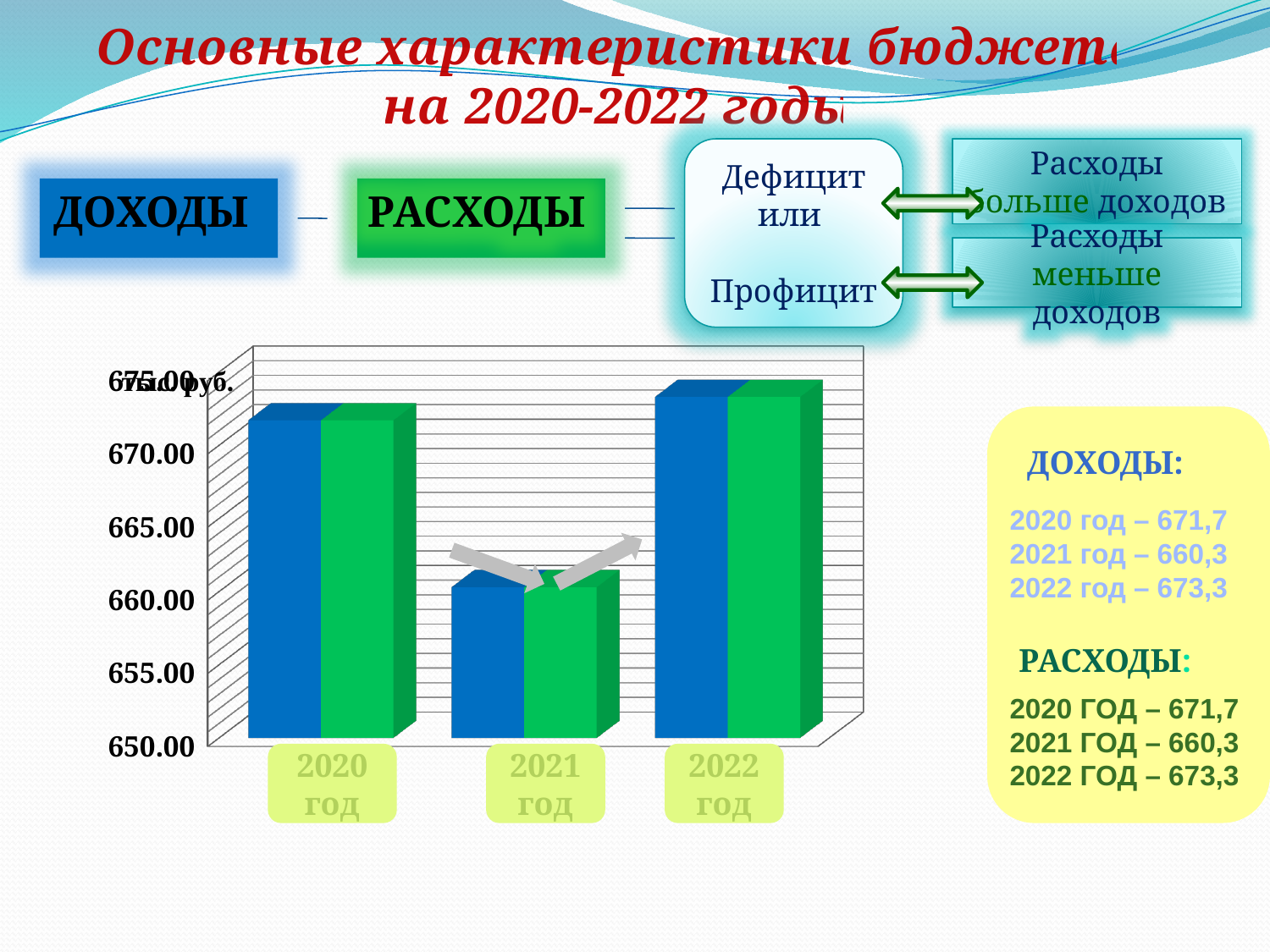
Which year has the highest bars in the chart? 2022 год Which year has the lowest bars in the chart? 2021 год Which is larger, the value for 2020 год or the value for 2021 год? 2020 год According to the slide, what is the value of ДОХОДЫ for 2021 год? 660,3 According to the slide, what is the value of РАСХОДЫ for 2022 год? 673,3 How many year categories are shown on the x axis of the chart? 3 By how much does the ДОХОДЫ value for 2022 год exceed the value for 2021 год? 13,0 Is the value for 2021 год greater or less than 665.00? less How do the values change from 2020 to 2022 along the x axis? fall in 2021, then rise in 2022 What kind of chart is shown on the slide? bar chart Is the value for 2020 год greater or less than 670.00? greater How many data series (bar colours) are plotted for each year in the chart? 2